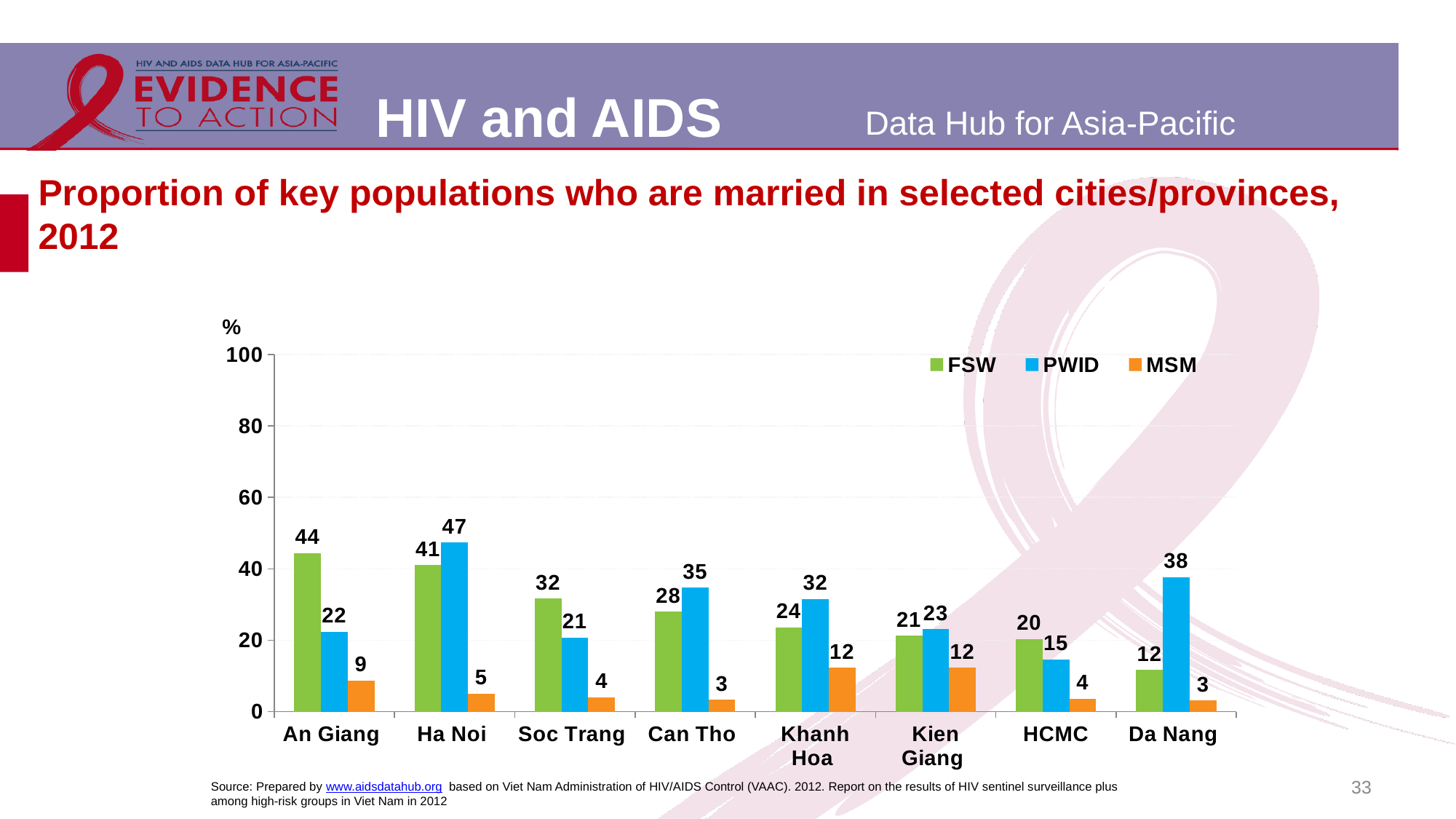
What is the MSM value for Khanh Hoa? 12 What is the PWID value for Da Nang? 38 Is the PWID value for Ha Noi greater or less than 40? greater Which city/province has the lowest FSW value? Da Nang How many cities/provinces are shown on the x axis? 8 How many series does the legend list? 3 What is the FSW value for An Giang? 44 What kind of chart is shown on the slide? Bar chart Which colour represents MSM in the legend? Orange Which city/province has the highest PWID value? Ha Noi Which is larger for Soc Trang, the FSW value or the PWID value? FSW What is the difference between the PWID and FSW values for Can Tho? 7